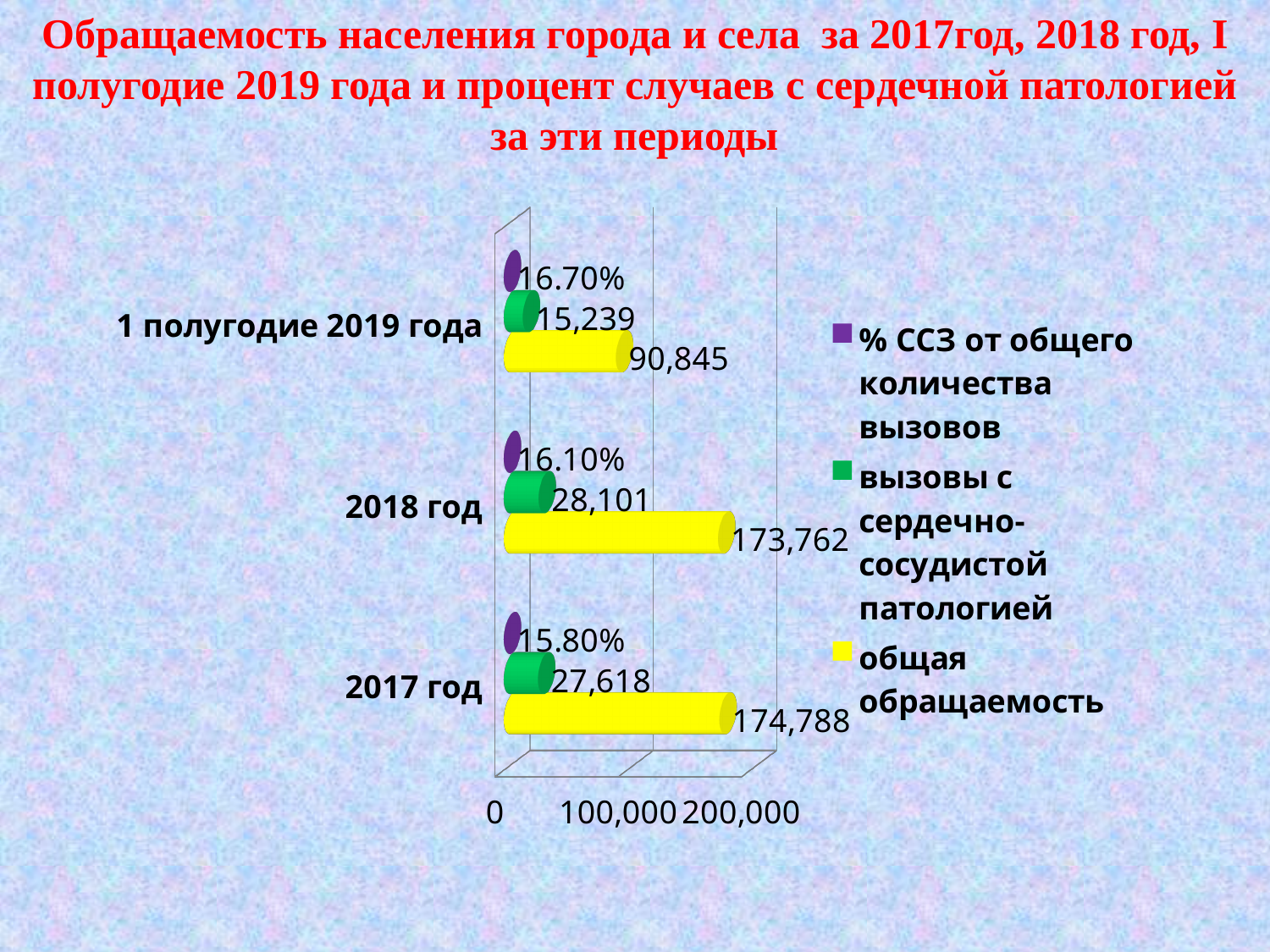
Which is larger: the % ССЗ от общего количества вызовов for 2018 год or for 2017 год? 2018 год What is the value of общая обращаемость for 1 полугодие 2019 года? 90,845 What is the value of общая обращаемость for 2017 год? 174,788 Which period has the highest общая обращаемость? 2017 год What is the % ССЗ от общего количества вызовов for 1 полугодие 2019 года? 16.70% How many series does the legend list? 3 Is the общая обращаемость for 1 полугодие 2019 года greater or less than 100,000? less What kind of chart is shown on the slide? bar chart What is the difference in общая обращаемость between 2017 год and 2018 год? 1,026 What is the value of вызовы с сердечно-сосудистой патологией for 2018 год? 28,101 Which period has the lowest вызовы с сердечно-сосудистой патологией? 1 полугодие 2019 года How many periods (categories) are shown on the chart? 3